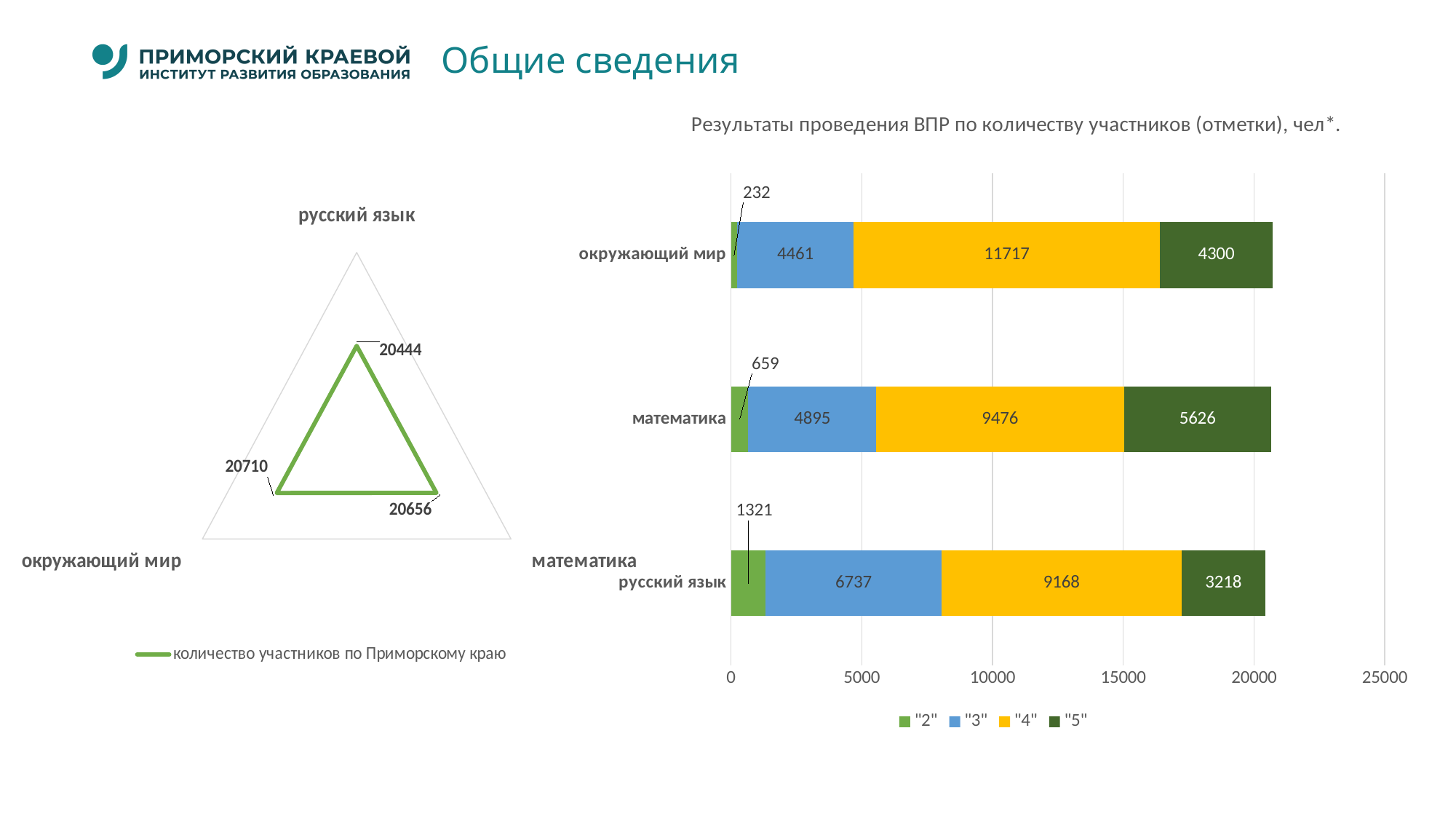
On the radar chart on the left, what is the difference between the values for окружающий мир and русский язык? 266 In the stacked bar chart on the right, what is the value of the "2" series for математика? 659 What type of chart is shown on the right side of the slide? stacked bar chart In the stacked bar chart on the right, is the "3" value for русский язык larger or the "3" value for математика? русский язык On the radar chart on the left, which subject has the highest number of participants? окружающий мир In the stacked bar chart on the right, which subject has the highest value for the "5" series? математика In the stacked bar chart on the right, what is the total of the stacked bar for русский язык? 20444 On the radar chart on the left, how many categories are plotted? 3 In the stacked bar chart on the right, which subject has the lowest value for the "2" series? окружающий мир In the stacked bar chart on the right, what is the value of the "4" series for окружающий мир? 11717 On the radar chart on the left, what is the value for русский язык? 20444 How many series does the legend of the stacked bar chart on the right list? 4